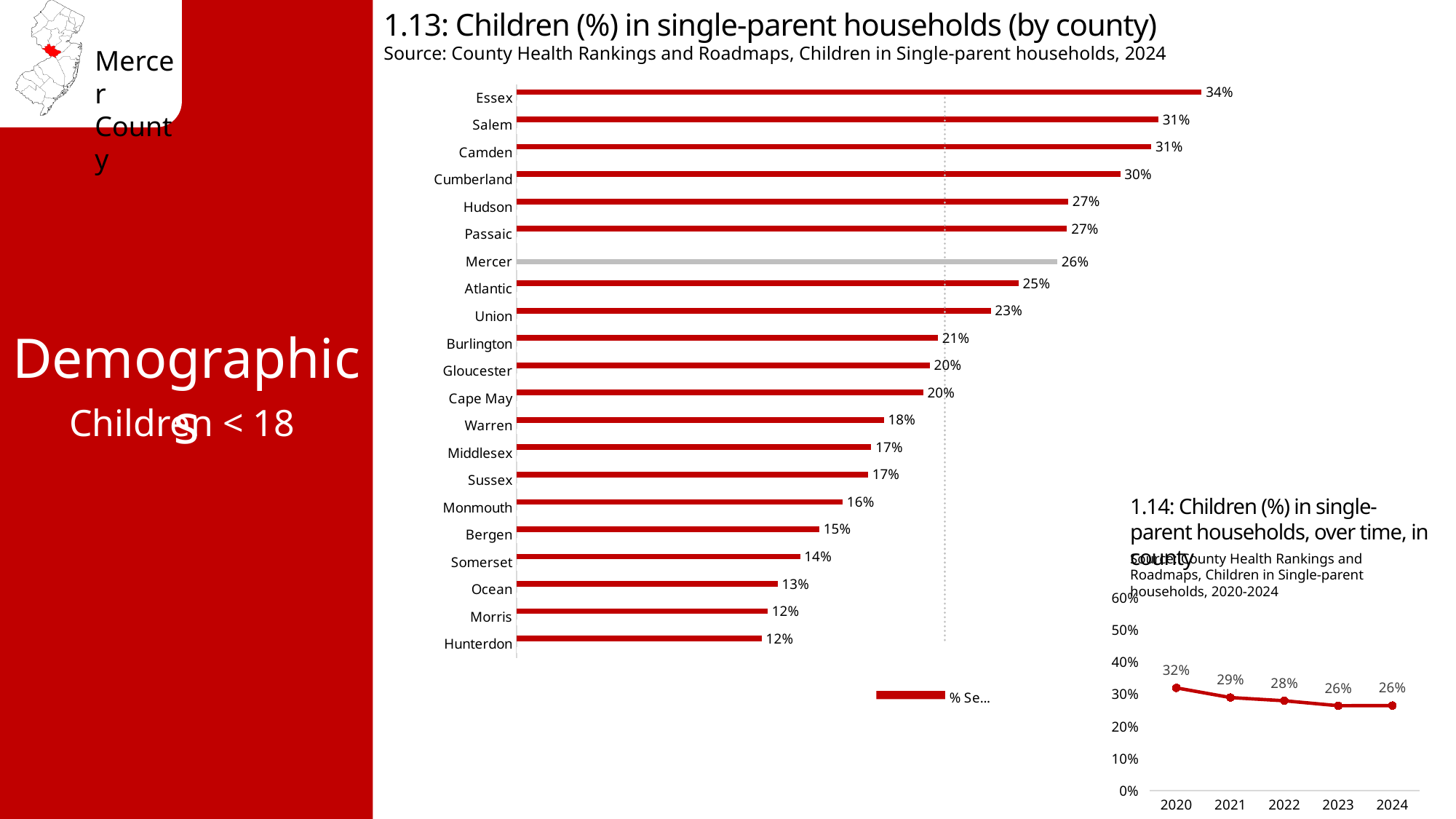
In chart 1.13 (by county), what is the value for Hunterdon? 12% In chart 1.13 (by county), how many counties are shown? 21 In chart 1.13 (Children (%) in single-parent households by county), what is the value for Mercer? 26% In chart 1.13 (by county), what is the value for Cumberland? 30% In chart 1.14 (over time), what is the difference between the 2020 value and the 2024 value? 6 percentage points What kind of chart is chart 1.13 (Children (%) in single-parent households by county)? Bar chart In chart 1.13 (by county), what is the difference between Essex and Mercer? 8 percentage points In chart 1.14 (over time), do the values rise or fall from 2020 to 2024? Fall In chart 1.14 (Children (%) in single-parent households over time), what is the value for 2020? 32% In chart 1.13 (by county), which is larger, the value for Hudson or the value for Union? Hudson In chart 1.13 (by county), which county has the highest percentage of children in single-parent households? Essex In chart 1.14 (over time), how many years are plotted? 5